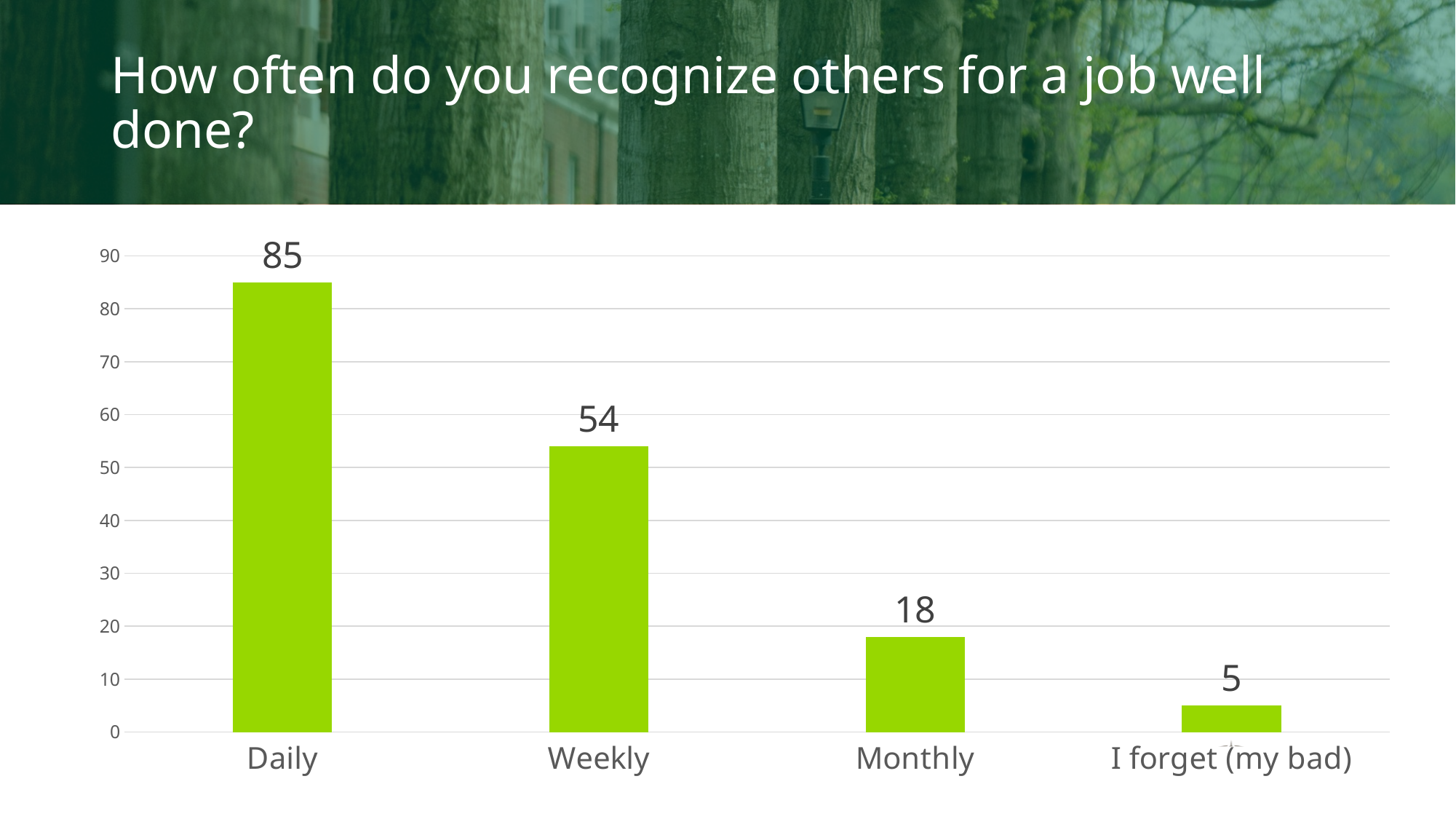
Which is larger, the value for Weekly or the value for Monthly? Weekly What is the value for Monthly? 18 Do the values rise or fall from left to right along the x axis? Fall What is the value for Daily? 85 What is the difference between the values for Monthly and 'I forget (my bad)'? 13 What is the value for Weekly? 54 Which category has the lowest value? I forget (my bad) How many categories are shown on the x axis? 4 Which category has the highest value? Daily What kind of chart is shown on the slide? Bar chart What is the difference between the values for Daily and Weekly? 31 What is the value for 'I forget (my bad)'? 5